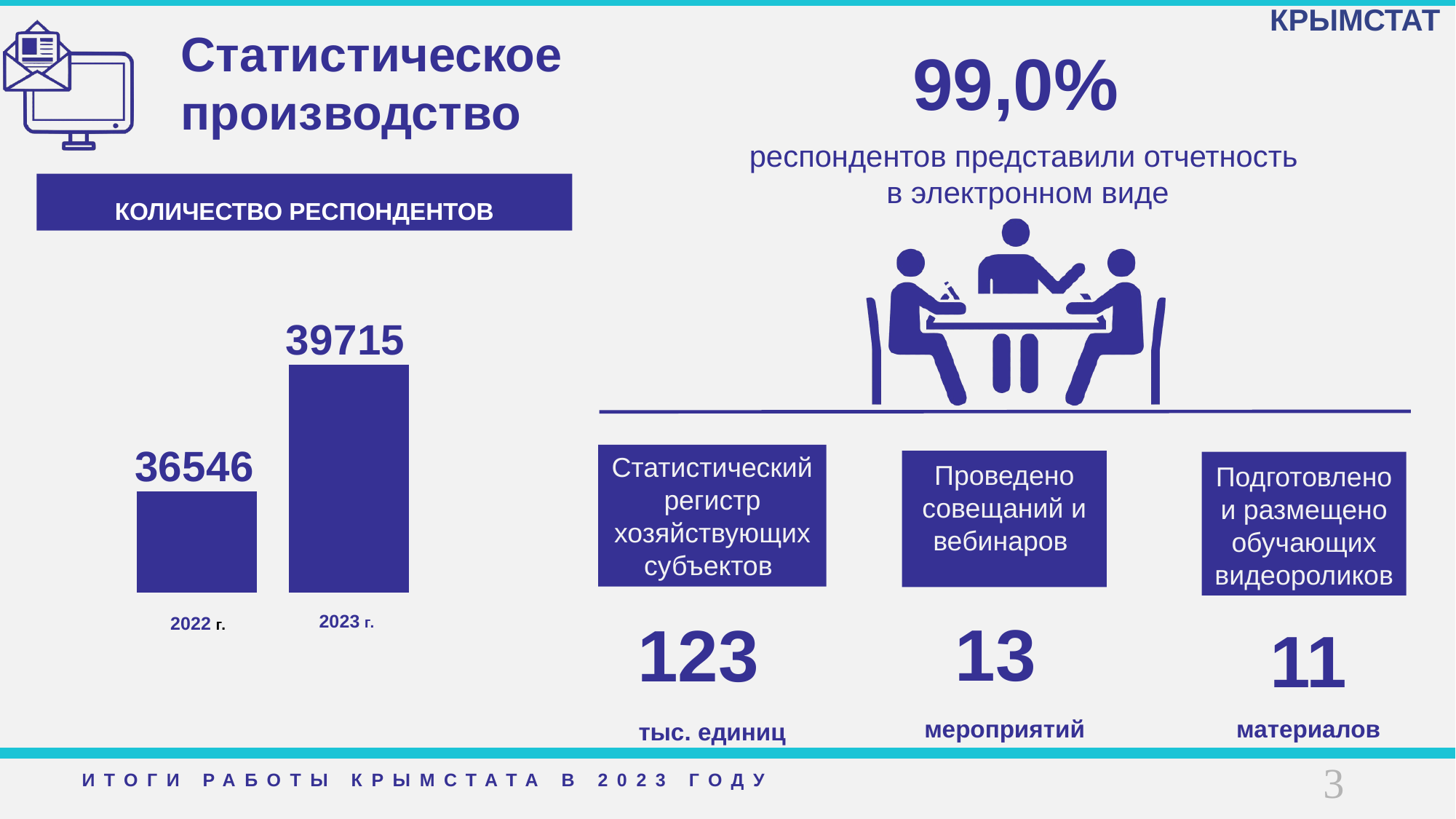
Which year has the lower number of respondents in the chart? 2022 г. By how much did the number of respondents increase from 2022 г. to 2023 г.? 3169 What colour are the bars in the КОЛИЧЕСТВО РЕСПОНДЕНТОВ chart? blue Is the value for 2023 г. larger or smaller than the value for 2022 г.? larger What type of chart is used to show the number of respondents? bar chart What is the title of the chart on the left of the slide? КОЛИЧЕСТВО РЕСПОНДЕНТОВ Which year has the higher number of respondents in the chart? 2023 г. What is the number of respondents for 2023 г. in the КОЛИЧЕСТВО РЕСПОНДЕНТОВ chart? 39715 How many categories (years) are shown in the КОЛИЧЕСТВО РЕСПОНДЕНТОВ chart? 2 Does the number of respondents rise or fall from 2022 г. to 2023 г.? rise What is the number of respondents for 2022 г. in the КОЛИЧЕСТВО РЕСПОНДЕНТОВ chart? 36546